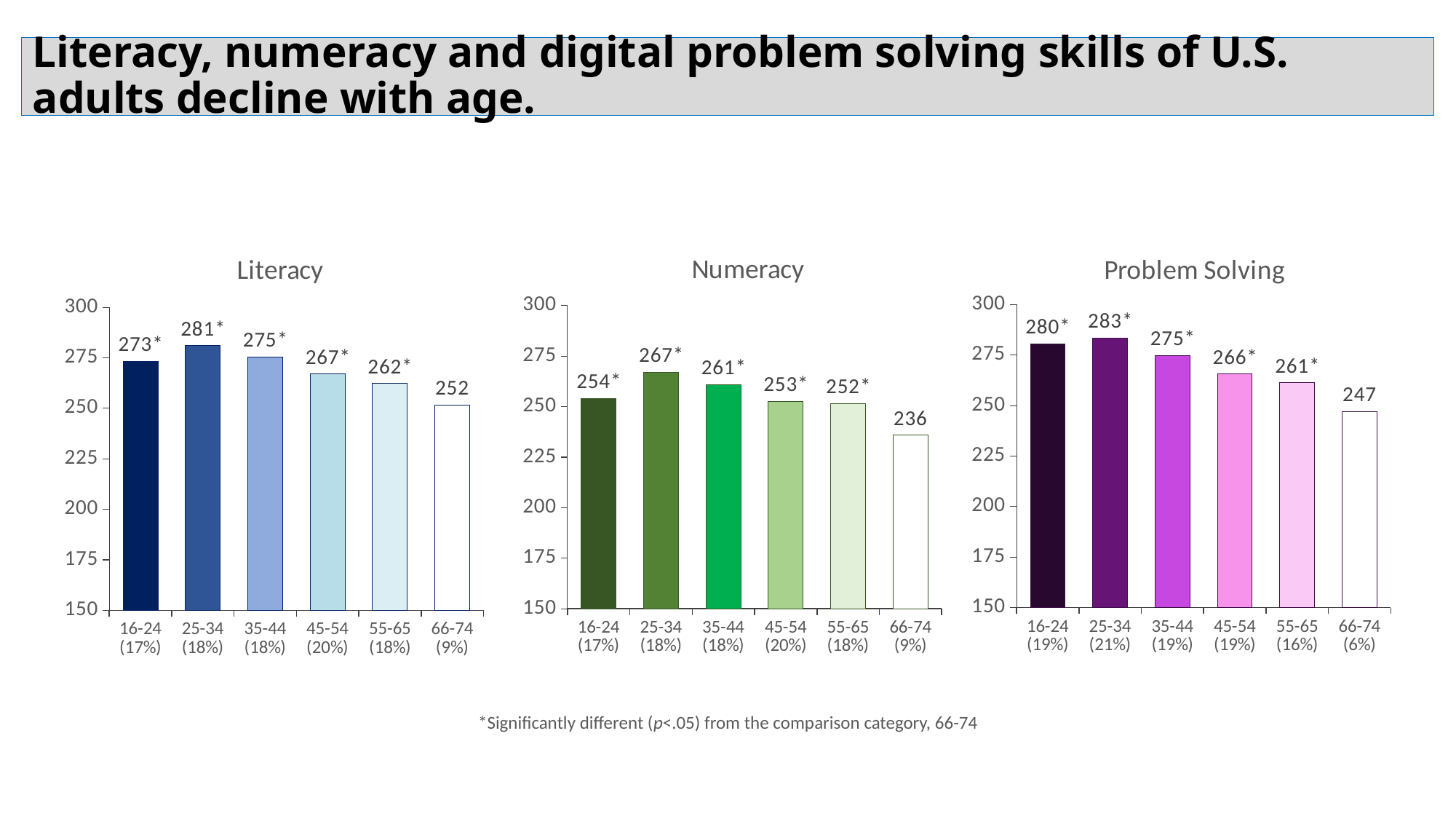
In the Problem Solving chart, is the value for 66-74 greater or less than 250? less In the Numeracy chart, which age group has the lowest value? 66-74 In the Literacy chart, what is the value for the 25-34 age group? 281 What is the title of the chart on the right of the slide? Problem Solving In the Problem Solving chart, what is the value for the 45-54 age group? 266 In the Problem Solving chart, do the values rise or fall from the 25-34 group to the 66-74 group? fall In the Literacy chart, what is the difference between the values for 25-34 and 66-74? 29 In the Problem Solving chart, which age group has the highest value? 25-34 What kind of chart is the Numeracy chart? bar chart In the Numeracy chart, what is the value for the 66-74 age group? 236 How many age groups are shown in the Literacy chart? 6 In the Numeracy chart, which is larger, the value for 16-24 or the value for 35-44? 35-44